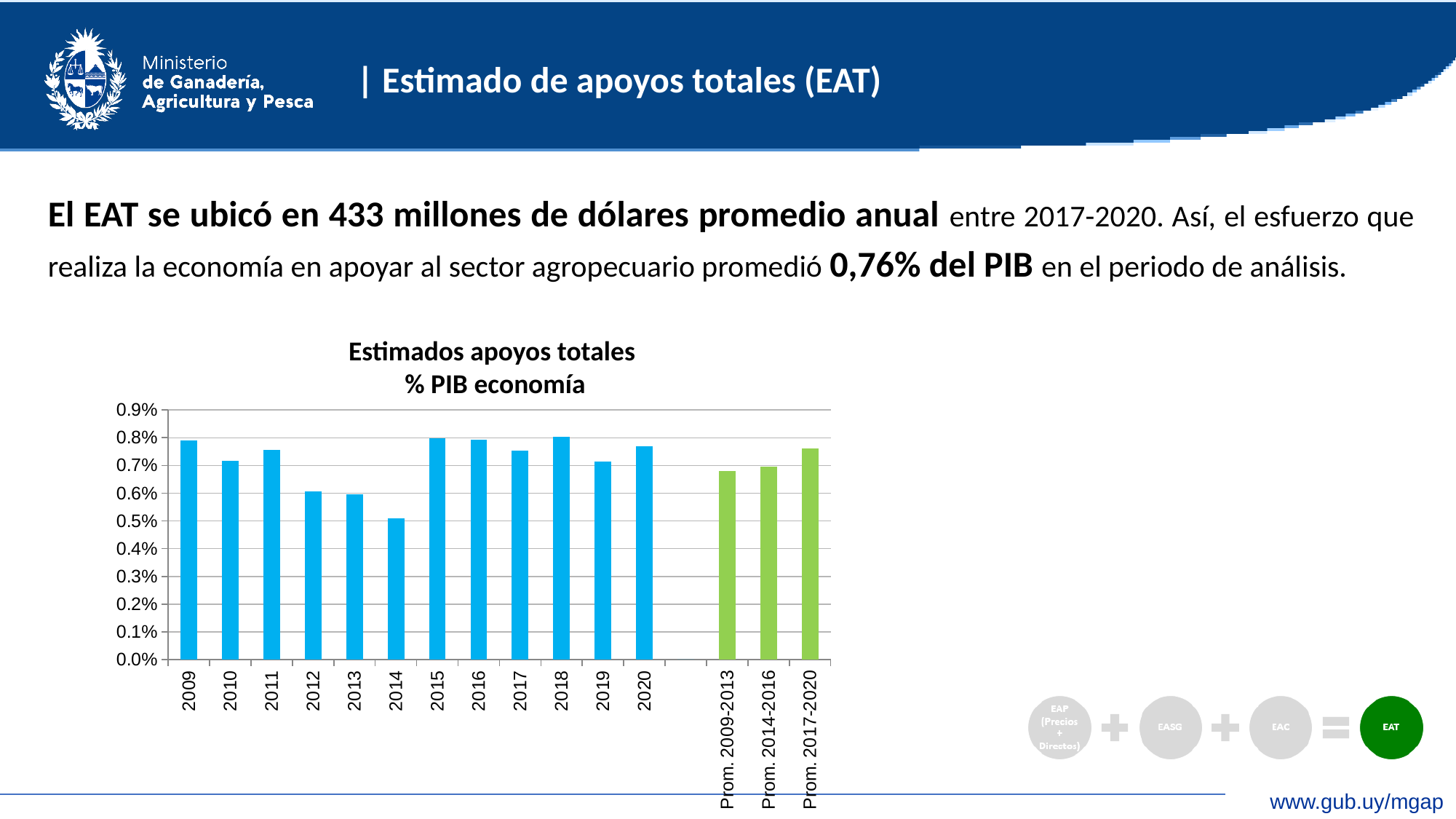
Which is larger, the value for 2009 or the value for 2014? 2009 Do the values rise or fall from 2011 to 2014? fall Which is larger, the value for Prom. 2017-2020 or the value for Prom. 2009-2013? Prom. 2017-2020 How many bars are plotted in the chart? 15 Which year has the lowest value in the chart? 2014 What kind of chart is shown on the slide? bar chart What is the title of the chart? Estimados apoyos totales % PIB economía Is the value for Prom. 2017-2020 greater or less than 0.7%? greater Is the value for Prom. 2009-2013 greater or less than 0.7%? less Is the value for 2014 greater or less than 0.6%? less How many individual years (excluding the 'Prom.' averages) are shown on the x axis? 12